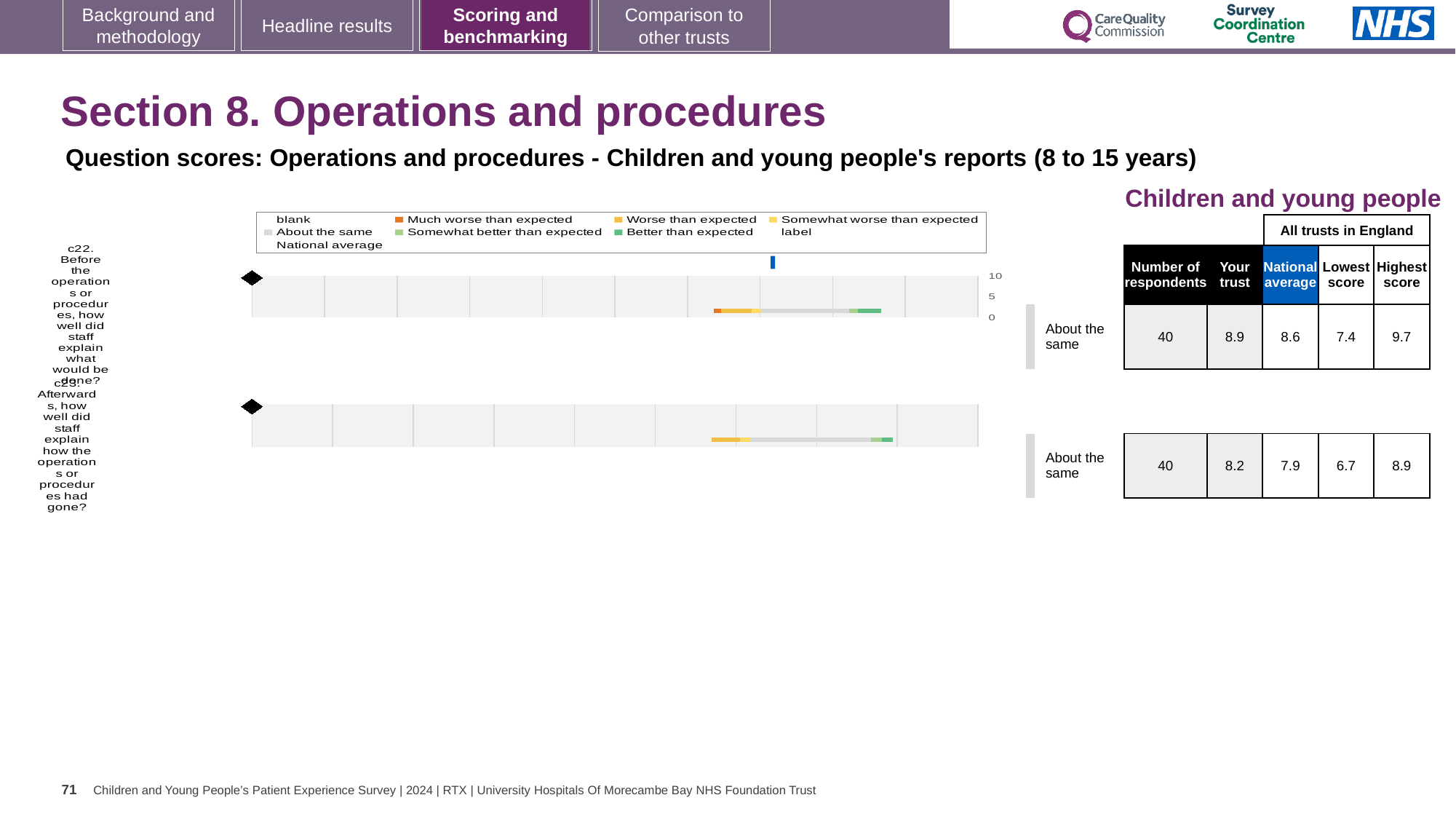
In the chart legend, what colour represents 'Much worse than expected'? orange For the c23 chart (Afterwards, how well did staff explain how the operations or procedures had gone?), what is the 'Your trust' score? 8.2 For the c23 chart, what is the difference between the 'Your trust' score and the National average? 0.3 For the c22 chart, what is the Highest score among all trusts in England? 9.7 What benchmark category label is shown next to the c22 chart? About the same For the c22 chart (Before the operations or procedures, how well did staff explain what would be done?), what is the 'Your trust' score in the table? 8.9 For the c22 chart, which is larger: the 'Your trust' score or the National average? Your trust What kind of chart is used for question c22 on the slide? bar chart How many question charts (c22 and c23) are shown on the slide? 2 For the c22 chart, what is the National average score shown in the table? 8.6 For the c23 chart, what is the Lowest score among all trusts in England? 6.7 How many respondents are listed for the c23 chart? 40